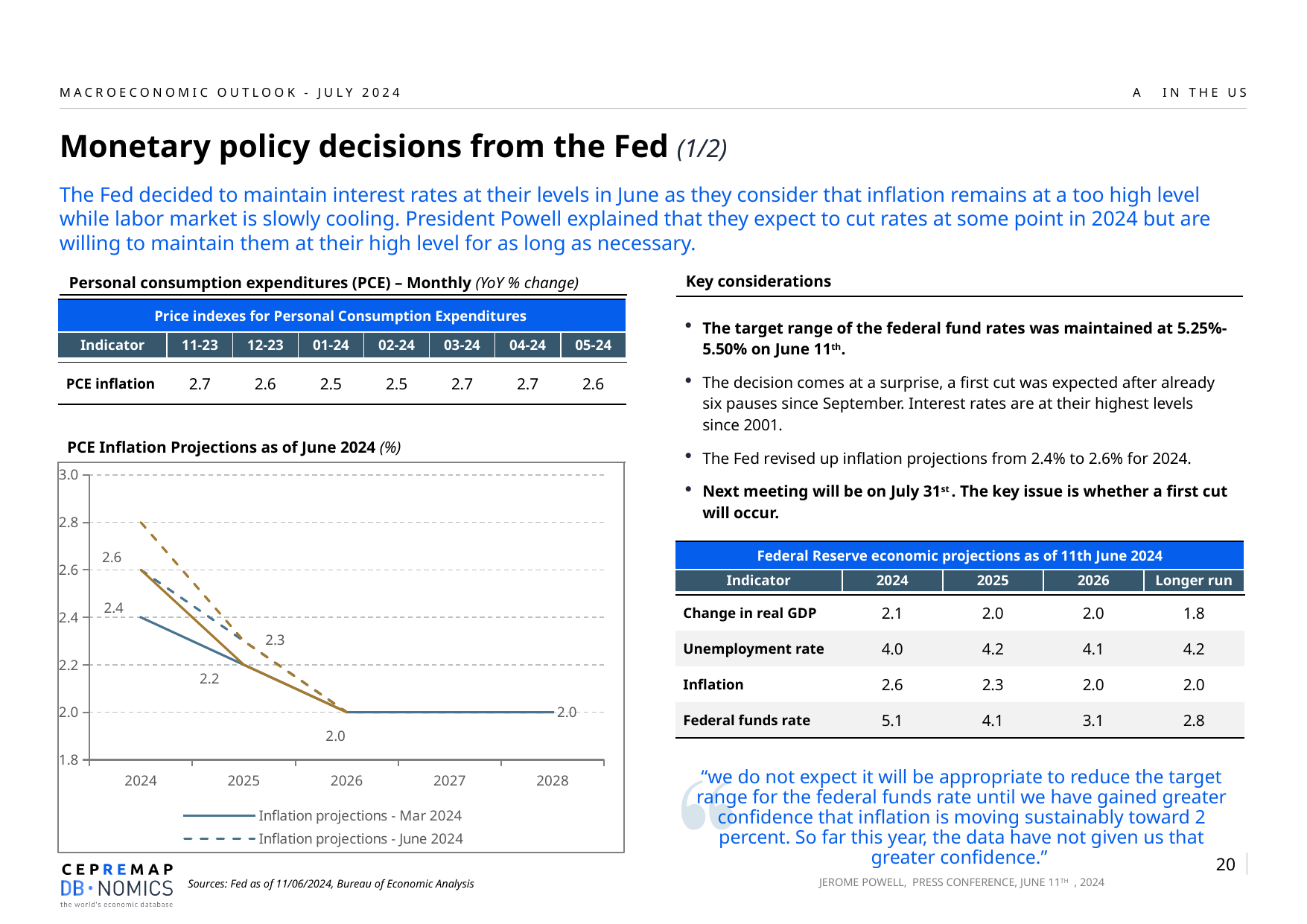
In the PCE Inflation Projections chart, by how much does the June 2024 projection for 2024 exceed the Mar 2024 projection for 2024? 0.2 How many series does the legend of the PCE Inflation Projections chart list? 2 In the PCE Inflation Projections chart, do the projections rise or fall from 2024 to 2026? fall In the PCE Inflation Projections chart, what is the June 2024 inflation projection for 2025? 2.3 What kind of chart is the 'PCE Inflation Projections as of June 2024' chart? line chart In the PCE Inflation Projections chart, what is the projected inflation value for 2028? 2.0 How many years are shown on the x axis of the PCE Inflation Projections chart? 5 In the PCE Inflation Projections chart, what is the June 2024 inflation projection for 2024? 2.6 In the PCE Inflation Projections chart, what is the Mar 2024 inflation projection for 2025? 2.2 In the PCE Inflation Projections chart, what is the Mar 2024 inflation projection for 2024? 2.4 In the PCE Inflation Projections chart, is the projected value for 2027 greater or less than 2.2? less In the PCE Inflation Projections chart, which is larger for 2024: the June 2024 projection or the Mar 2024 projection? June 2024 projection